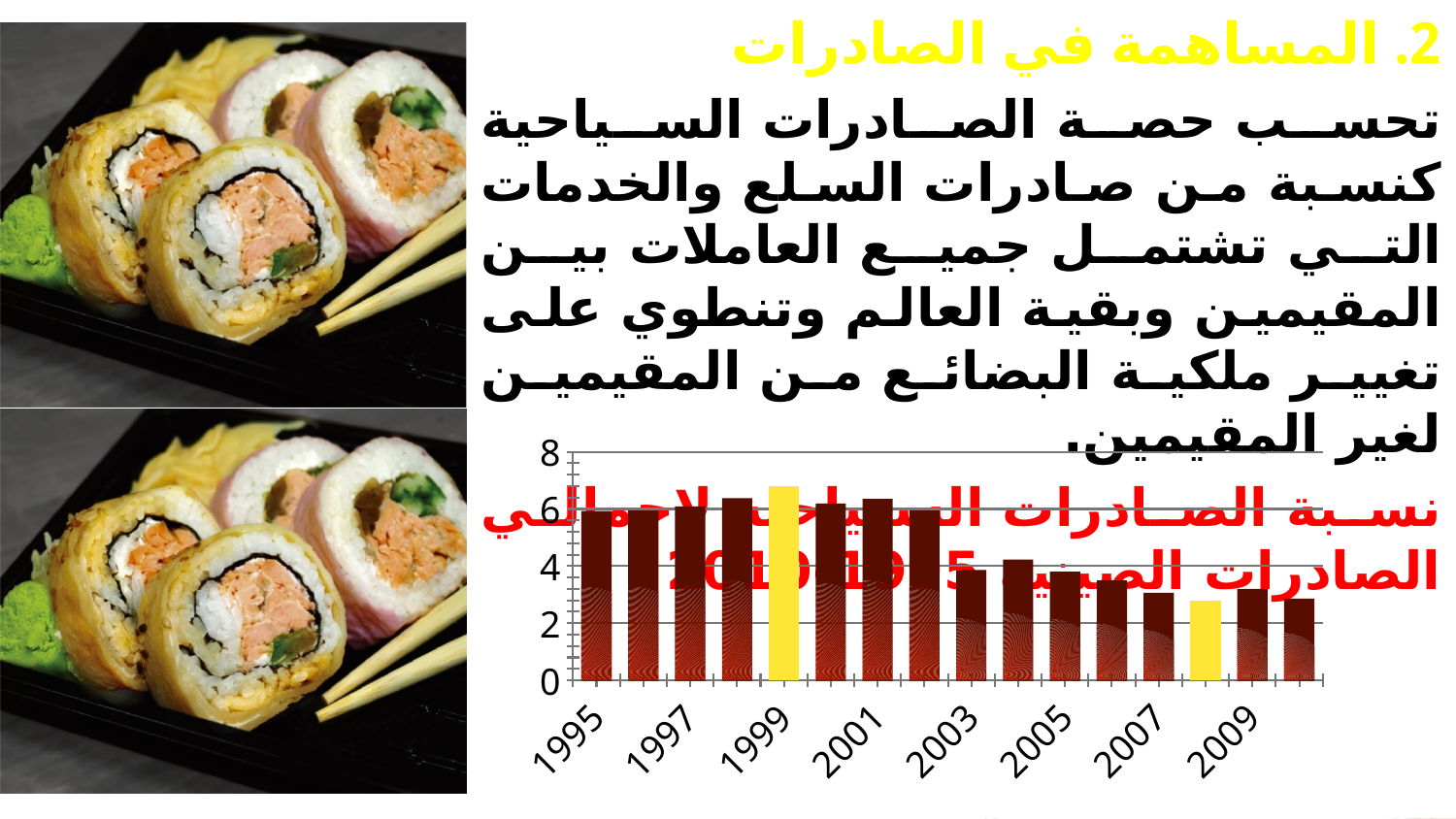
Which year has the highest bar in the chart? 1999 Which is larger, the value for 1998 or the value for 2003? 1998 What kind of chart is shown on the slide? bar chart Is the value for 1995 greater or less than 4? greater How many bars (years) are plotted in the chart? 16 Overall, do the values rise or fall from 1995 to 2010? fall Which two years are highlighted with yellow bars in the chart? 1999 and 2008 Is the value for 2008 greater or less than 4? less Is the value for 2010 greater or less than 4? less Which is larger, the value for 2008 or the value for 1999? 1999